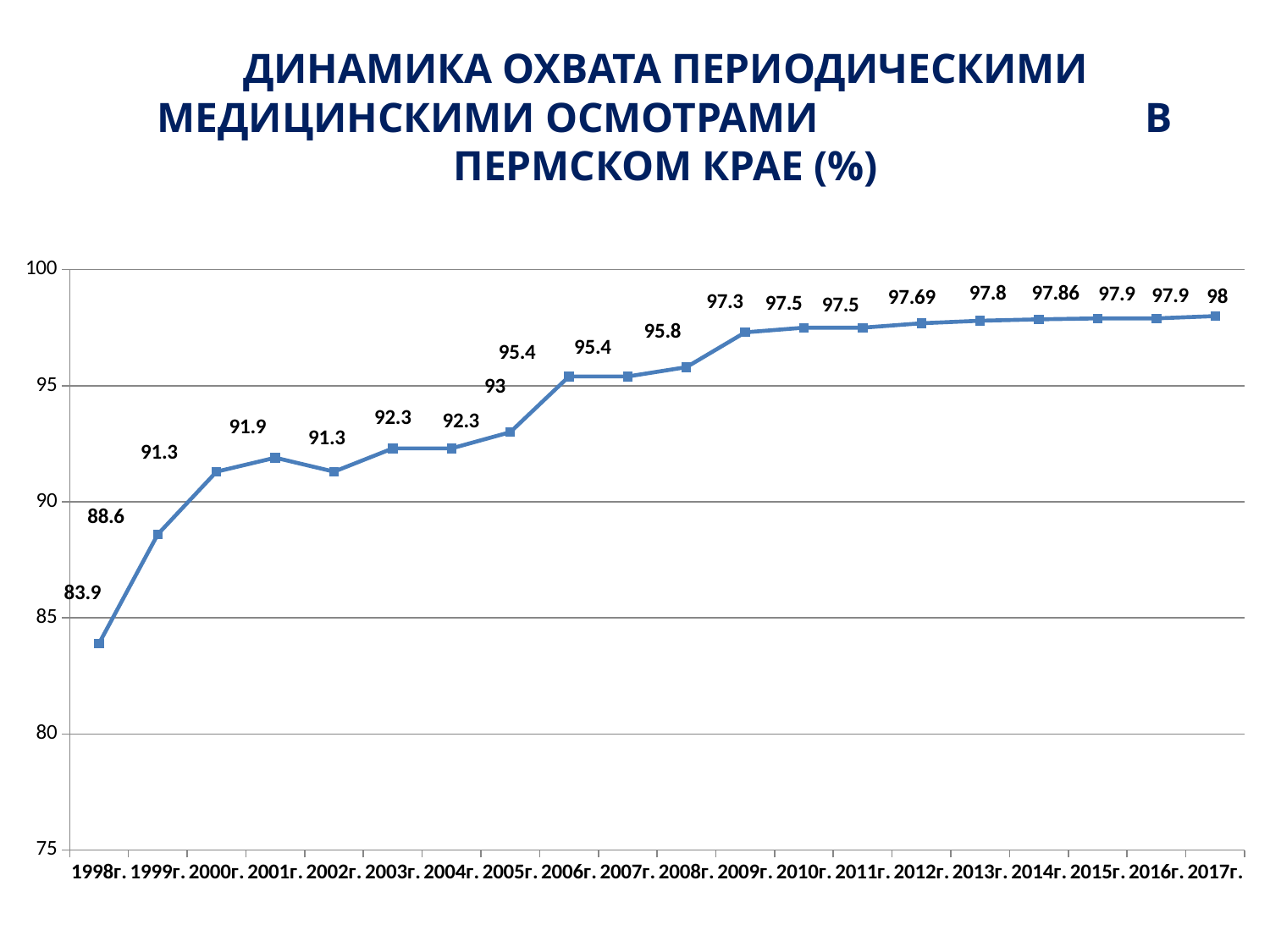
How many years are plotted on the chart? 20 Which is larger, the value for 2001г. or the value for 2002г.? 2001г. Which year has the highest value? 2017г. Is the value for 2008г. greater or less than 95? greater What is the value for 2012г.? 97.69 What is the difference between the values for 1999г. and 1998г.? 4.7 What is the value for 2005г.? 93 Which year has the lowest value? 1998г. What is the value for 1998г.? 83.9 What is the value for 2017г.? 98 What kind of chart is shown on the slide? line chart Do the values generally rise or fall from 1998г. to 2017г.? rise